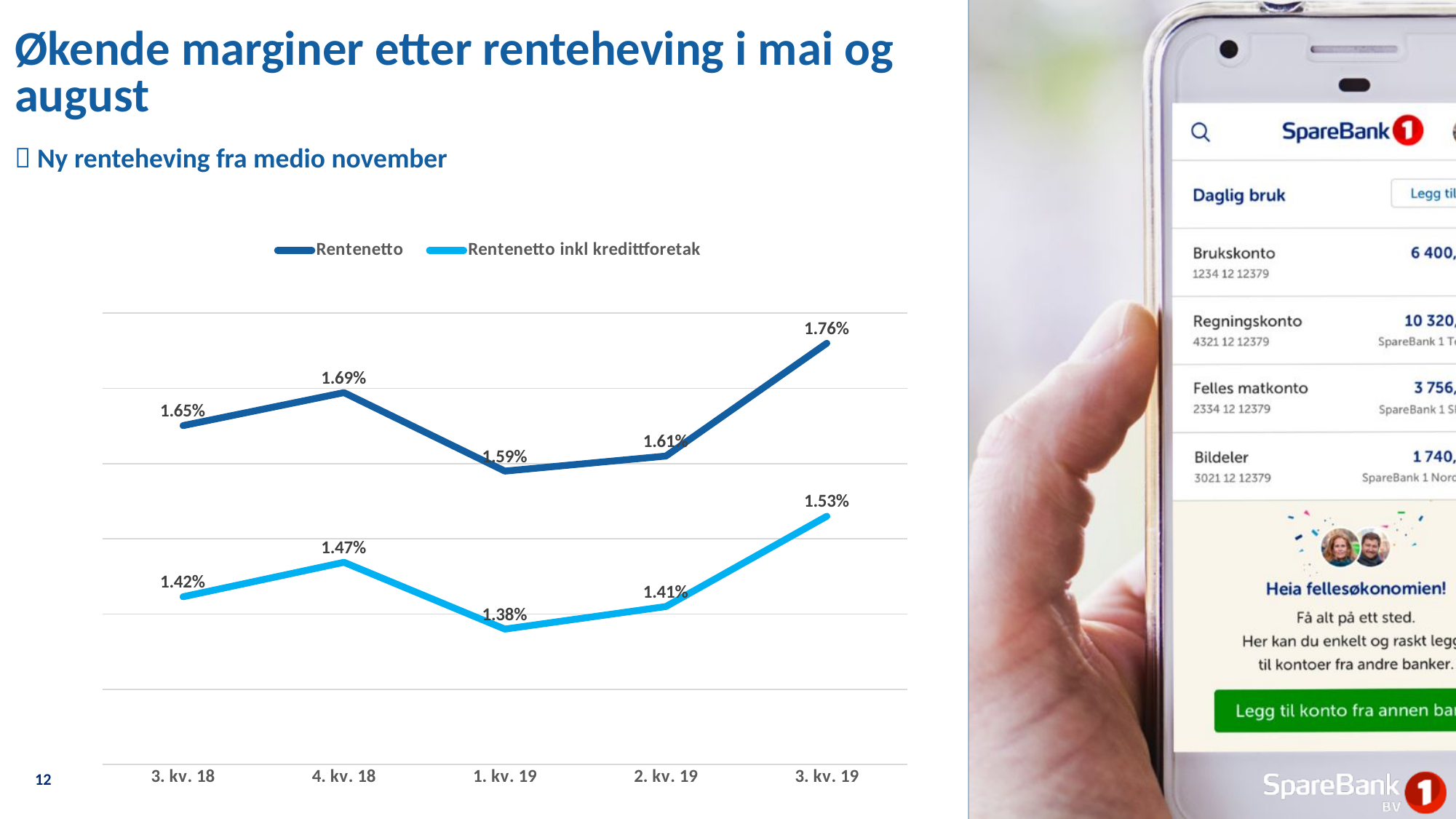
How many quarters are shown on the x axis? 5 Which series is drawn in the lighter blue colour? Rentenetto inkl kredittforetak What is the difference between Rentenetto and Rentenetto inkl kredittforetak in 3. kv. 19? 0.23% What kind of chart is shown on the slide? Line chart Which is larger: Rentenetto in 3. kv. 18 or Rentenetto in 2. kv. 19? Rentenetto in 3. kv. 18 Does Rentenetto inkl kredittforetak rise or fall from 2. kv. 19 to 3. kv. 19? Rise What is the value of Rentenetto inkl kredittforetak for 1. kv. 19? 1.38% What is the value of Rentenetto for 3. kv. 19? 1.76% In which quarter is Rentenetto lowest? 1. kv. 19 In which quarter is Rentenetto inkl kredittforetak highest? 3. kv. 19 How many series does the legend list? 2 What is the value of Rentenetto for 4. kv. 18? 1.69%